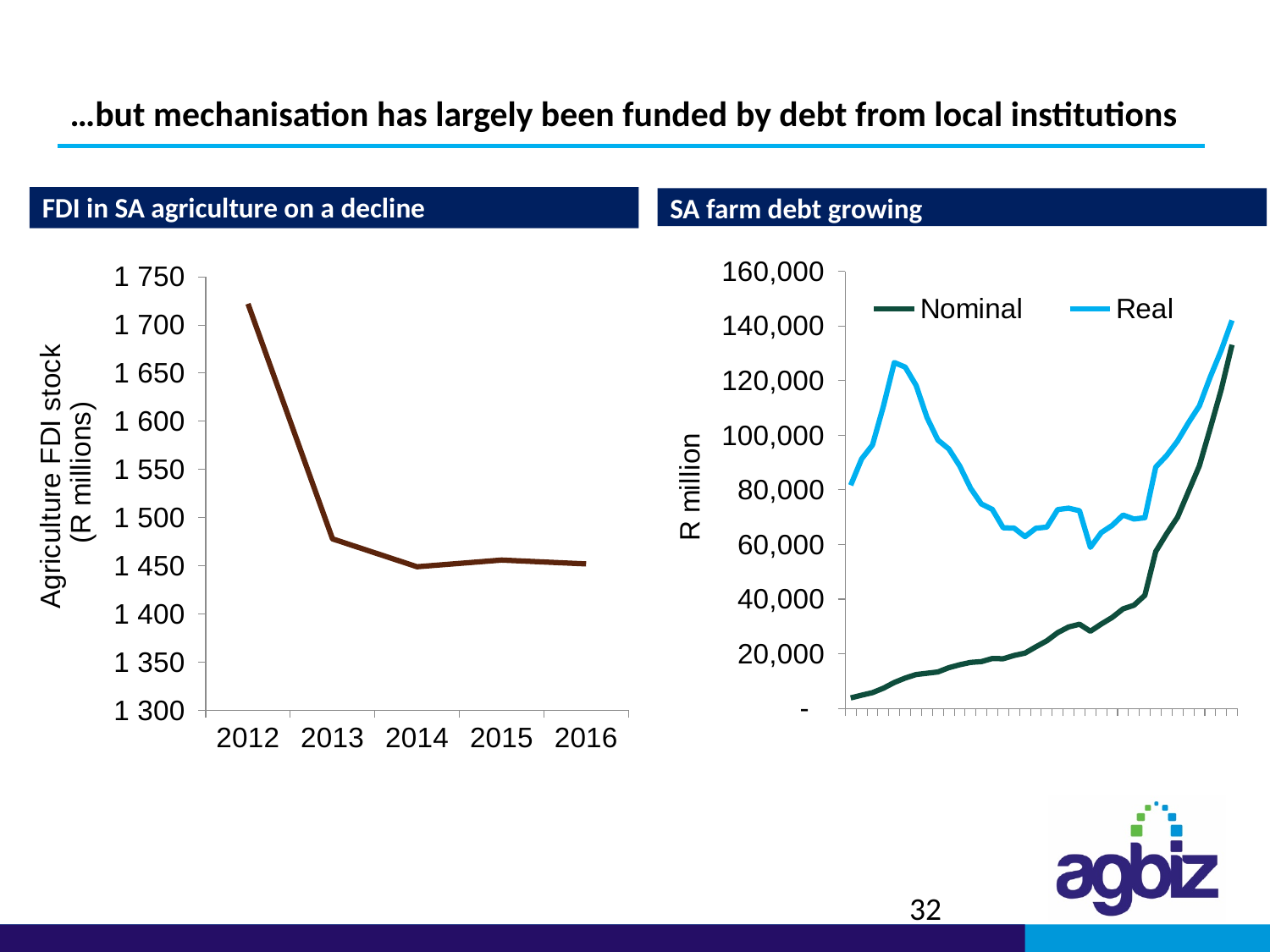
In the 'FDI in SA agriculture on a decline' chart, does the Agriculture FDI stock rise or fall from 2012 to 2016? fall What kind of chart is the 'FDI in SA agriculture on a decline' chart? line chart In the 'FDI in SA agriculture on a decline' chart, how many years are plotted on the x axis? 5 In the 'FDI in SA agriculture on a decline' chart, is the value for 2013 greater or less than 1 500? less What kind of chart is the 'SA farm debt growing' chart? line chart In the 'FDI in SA agriculture on a decline' chart, is the value for 2012 greater or less than 1 700? greater In the 'FDI in SA agriculture on a decline' chart, which year has the highest Agriculture FDI stock? 2012 How many series does the legend of the 'SA farm debt growing' chart list? 2 In the 'SA farm debt growing' chart, what is the y-axis label? R million In the 'FDI in SA agriculture on a decline' chart, which is larger, the value for 2012 or the value for 2014? 2012 In the 'SA farm debt growing' chart, does the Nominal series rise or fall along the x axis? rise In the 'SA farm debt growing' chart, is the first value of the Nominal series greater or less than 20,000? less